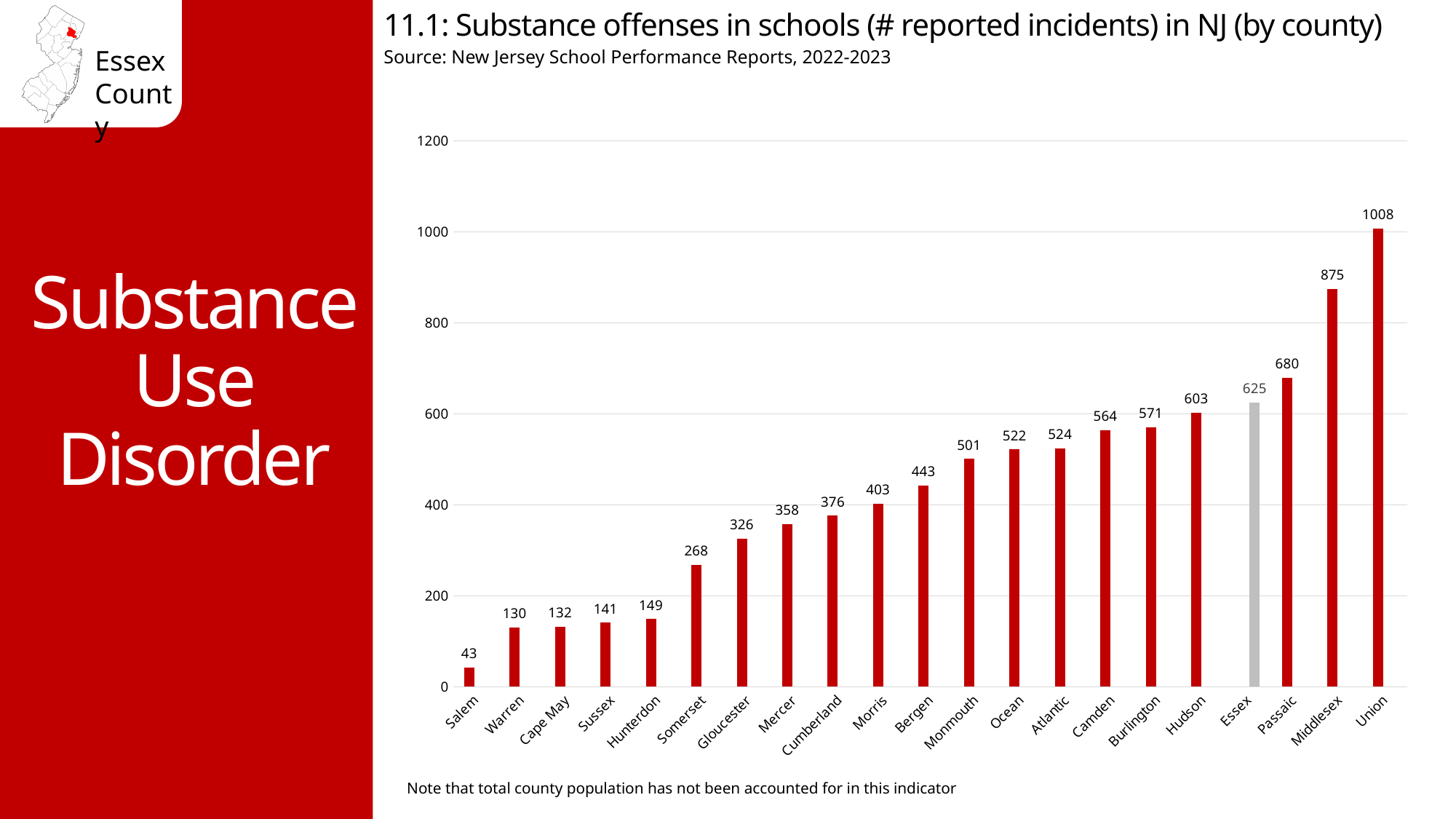
What is the difference between the values for Union and Middlesex? 133 Which county's bar is shown in gray rather than red? Essex How many counties are shown on the chart? 21 Which county has a higher value, Hudson or Camden? Hudson What type of chart is shown on the slide? Bar chart What is the value shown for Middlesex County? 875 Which county has the lowest number of reported substance offenses in schools? Salem Is the value for Bergen greater or less than 400? greater What is the number of reported substance offense incidents in schools for Essex County? 625 What is the difference between the values for Passaic and Essex? 55 Do the values rise or fall moving from left to right along the x axis? Rise Which county has the highest number of reported substance offenses in schools? Union